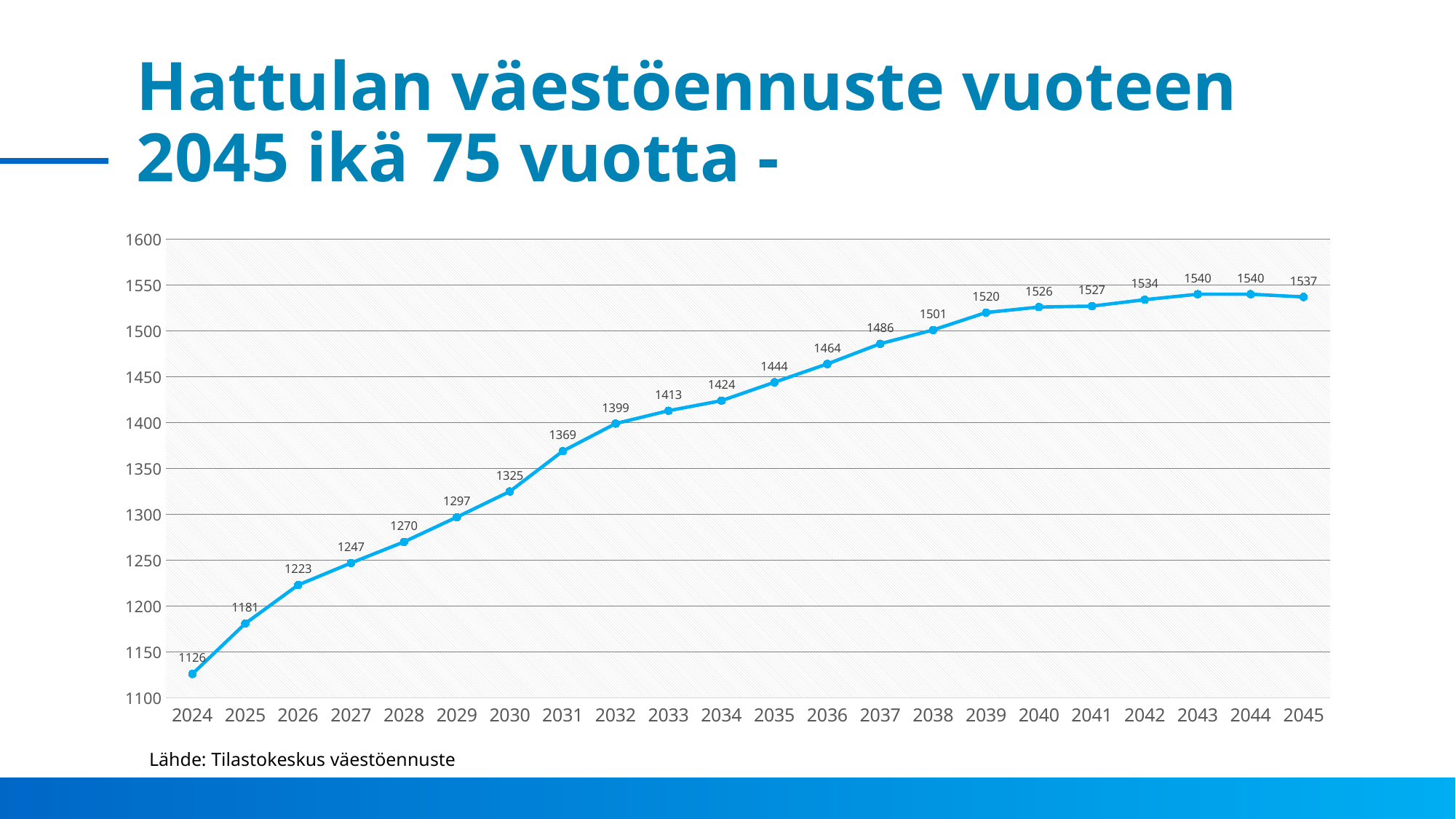
Which is larger, the value for 2038 or the value for 2036? 2038 What is the difference between the values for 2025 and 2024? 55 What kind of chart is shown on the slide? line chart What is the projected value for 2045? 1537 How many years are plotted on the chart? 22 Is the value for 2030 greater or less than 1300? greater Which year has the lowest value on the chart? 2024 What is the projected value for 2024? 1126 Do the values generally rise or fall from 2024 to 2045? rise What is the highest value shown on the chart? 1540 What is the value shown for 2032? 1399 What is the difference between the values for 2045 and 2024? 411